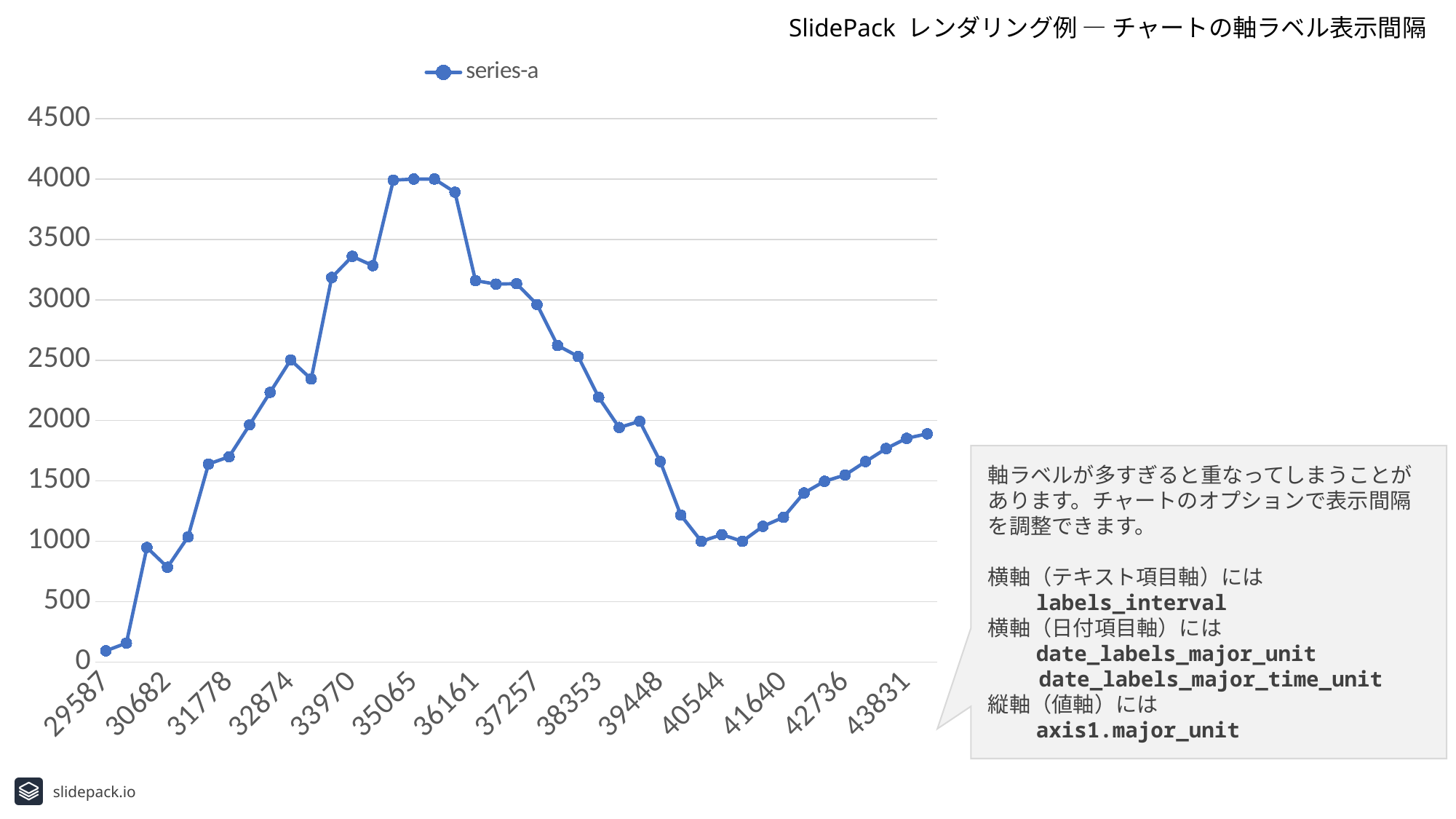
Is the value for 29587 greater or less than 500? less What is the name of the series shown in the legend? series-a Which x-axis category has the lowest value of series-a? 29587 Is the value for 33970 greater or less than 3000? greater How many series does the legend list? 1 What kind of chart is shown on the slide? line chart Is the highest value of series-a greater or less than 3500? greater Do the values of series-a rise or fall between 36161 and 40544? fall How many category labels are shown on the x axis? 14